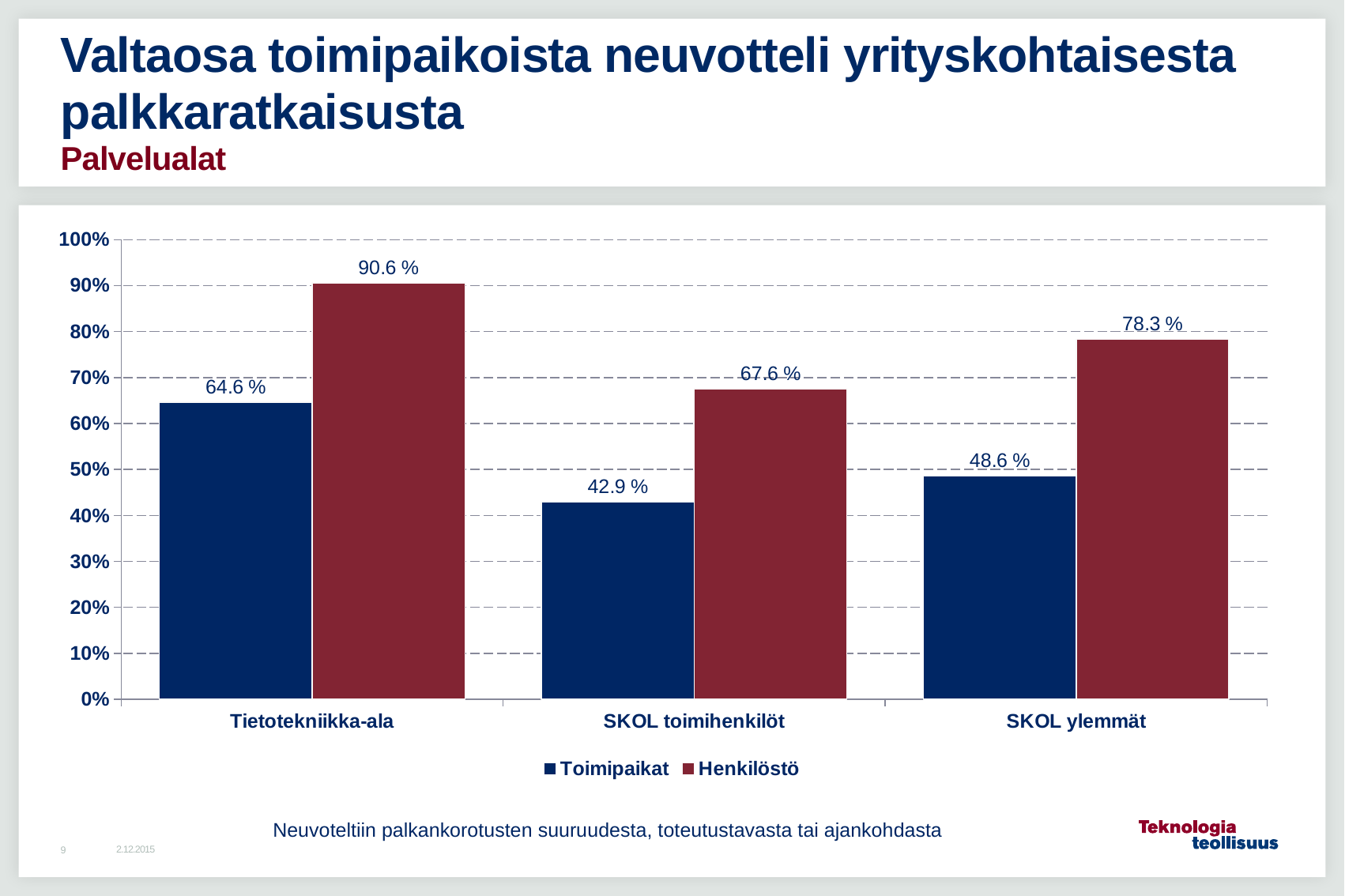
Which category has the highest Henkilöstö value? Tietotekniikka-ala What is the difference between the Henkilöstö and Toimipaikat values for SKOL ylemmät? 29.7 % What is the Henkilöstö value for SKOL toimihenkilöt? 67.6 % What kind of chart is shown on the slide? Bar chart What is the Henkilöstö value for SKOL ylemmät? 78.3 % How many categories are shown on the x axis? 3 What is the Toimipaikat value for Tietotekniikka-ala? 64.6 % Which is larger for SKOL toimihenkilöt, the Toimipaikat value or the Henkilöstö value? Henkilöstö What is the Toimipaikat value for SKOL toimihenkilöt? 42.9 % What is the difference between the Henkilöstö values for Tietotekniikka-ala and SKOL ylemmät? 12.3 % Which category has the lowest Toimipaikat value? SKOL toimihenkilöt How many series does the legend list? 2